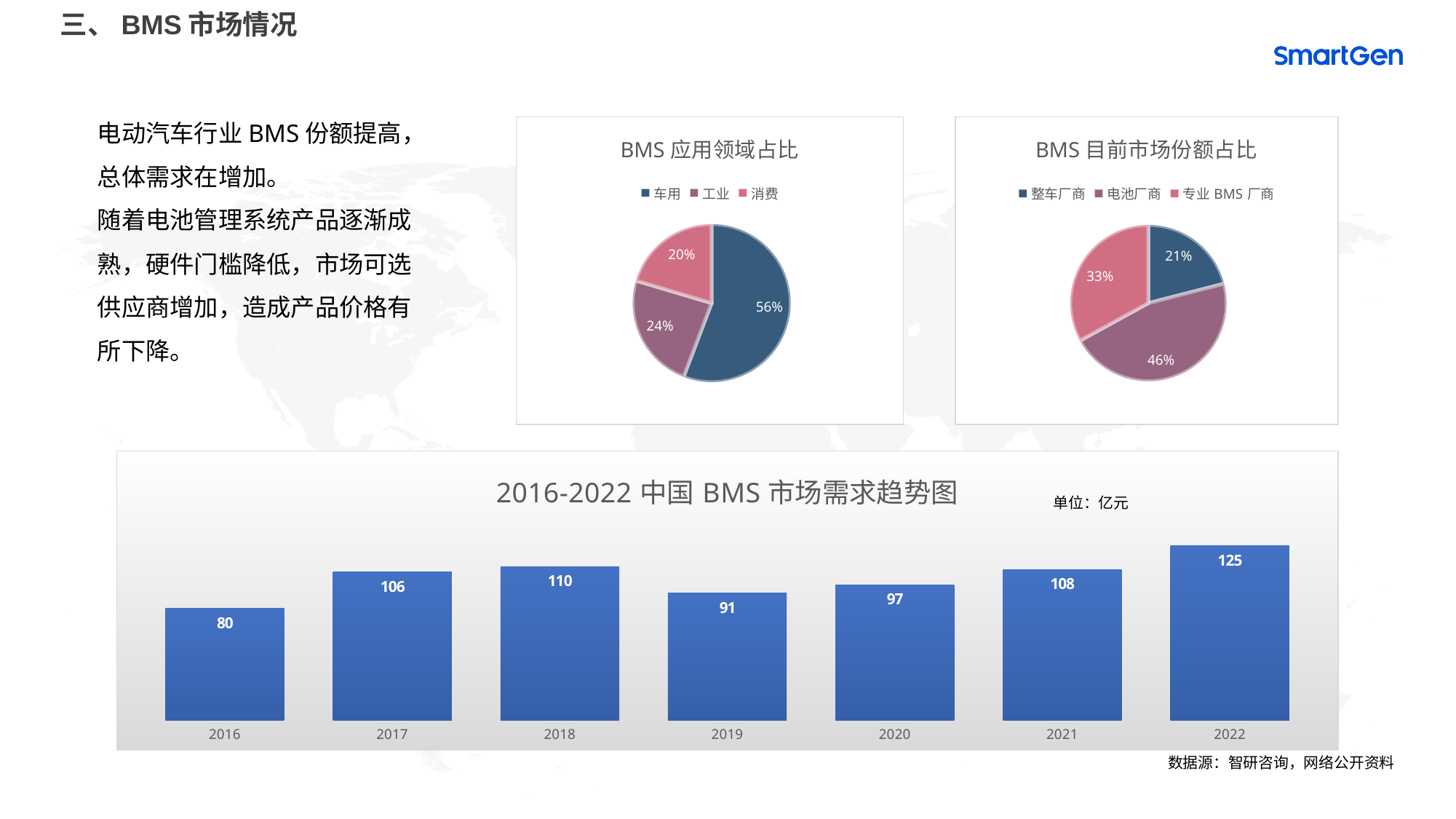
In the '2016-2022 中国 BMS 市场需求趋势图' chart, which year has the lowest value? 2016 In the 'BMS 目前市场份额占比' pie chart, which category has the largest share? 电池厂商 In the 'BMS 目前市场份额占比' pie chart, what share does 电池厂商 have? 46% In the '2016-2022 中国 BMS 市场需求趋势图' chart, which year has the highest value? 2022 In the '2016-2022 中国 BMS 市场需求趋势图' chart, what is the difference between the values for 2022 and 2016? 45 In the '2016-2022 中国 BMS 市场需求趋势图' chart, what is the value for 2019? 91 In the 'BMS 应用领域占比' pie chart, what share does 车用 have? 56% In the 'BMS 应用领域占比' pie chart, which category has the smallest share? 消费 How many years are shown in the '2016-2022 中国 BMS 市场需求趋势图' chart? 7 In the 'BMS 目前市场份额占比' pie chart, what is the difference between the shares of 专业 BMS 厂商 and 整车厂商? 12% How many series does the legend of the 'BMS 应用领域占比' chart list? 3 What kind of chart is '2016-2022 中国 BMS 市场需求趋势图'? bar chart